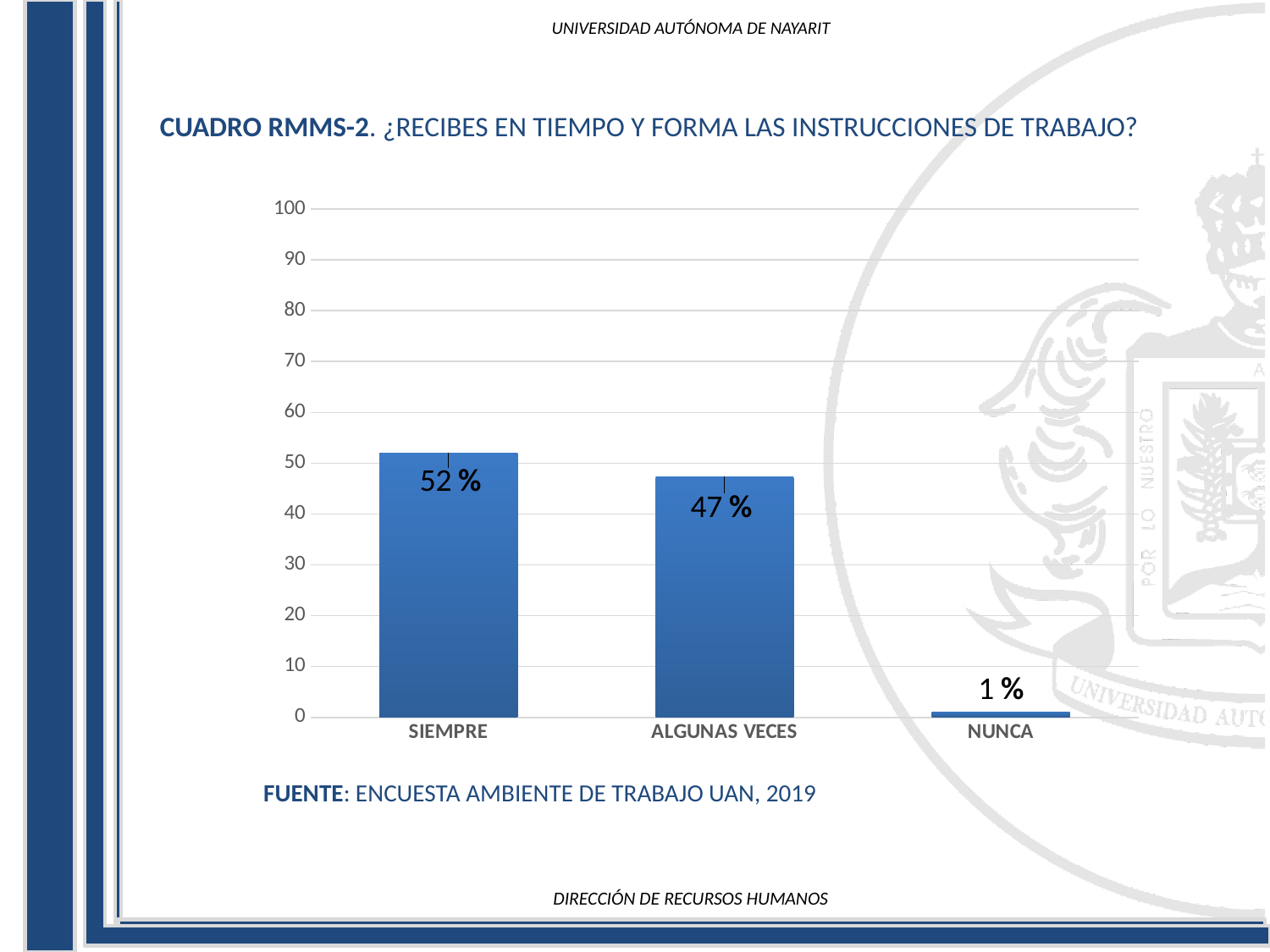
Which category has the lowest value? NUNCA What is the difference between the values for SIEMPRE and ALGUNAS VECES? 5 % What is the value for ALGUNAS VECES? 47 % What kind of chart is shown on the slide? bar chart Which category has the highest value? SIEMPRE Is the value for ALGUNAS VECES greater or less than 50? less What is the source cited below the chart? ENCUESTA AMBIENTE DE TRABAJO UAN, 2019 What is the difference between the values for ALGUNAS VECES and NUNCA? 46 % Which is larger, the value for SIEMPRE or the value for ALGUNAS VECES? SIEMPRE How many categories are shown on the x axis? 3 What is the value for SIEMPRE? 52 % What is the value for NUNCA? 1 %